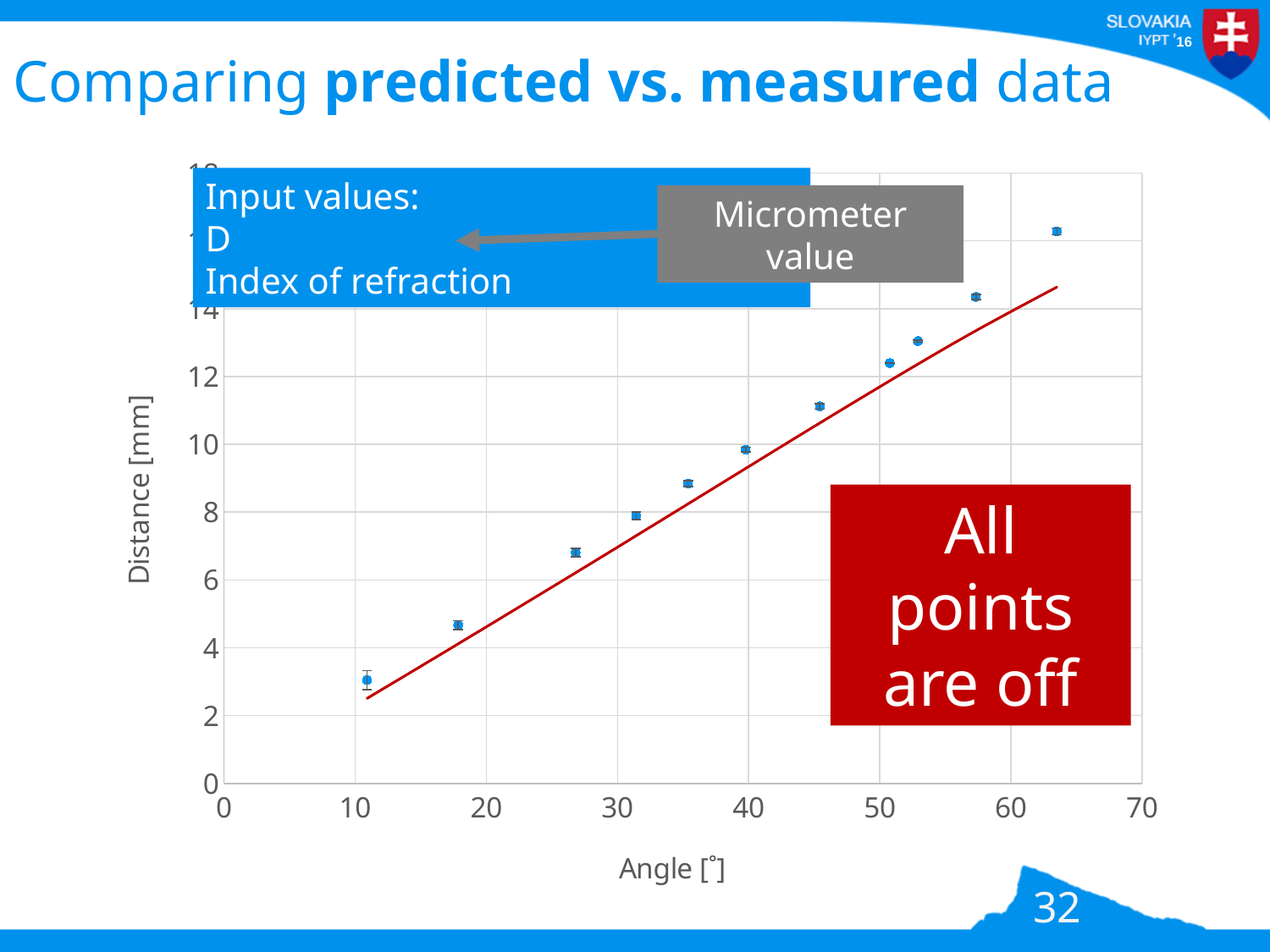
Which lies higher at an angle of about 45°: the measured point or the red predicted line? The measured point Is the measured distance for the point at about 18° greater or less than 6 mm? less Is the measured distance for the point at about 18° greater or less than 4 mm? greater What is the label of the y axis? Distance [mm] How many measured data points are plotted? 11 Do the measured distance values rise or fall as the angle increases? Rise Is the measured distance for the point at about 11° greater or less than 4 mm? less What is the label of the x axis? Angle [°] What kind of chart is shown on the slide? Scatter plot with a line